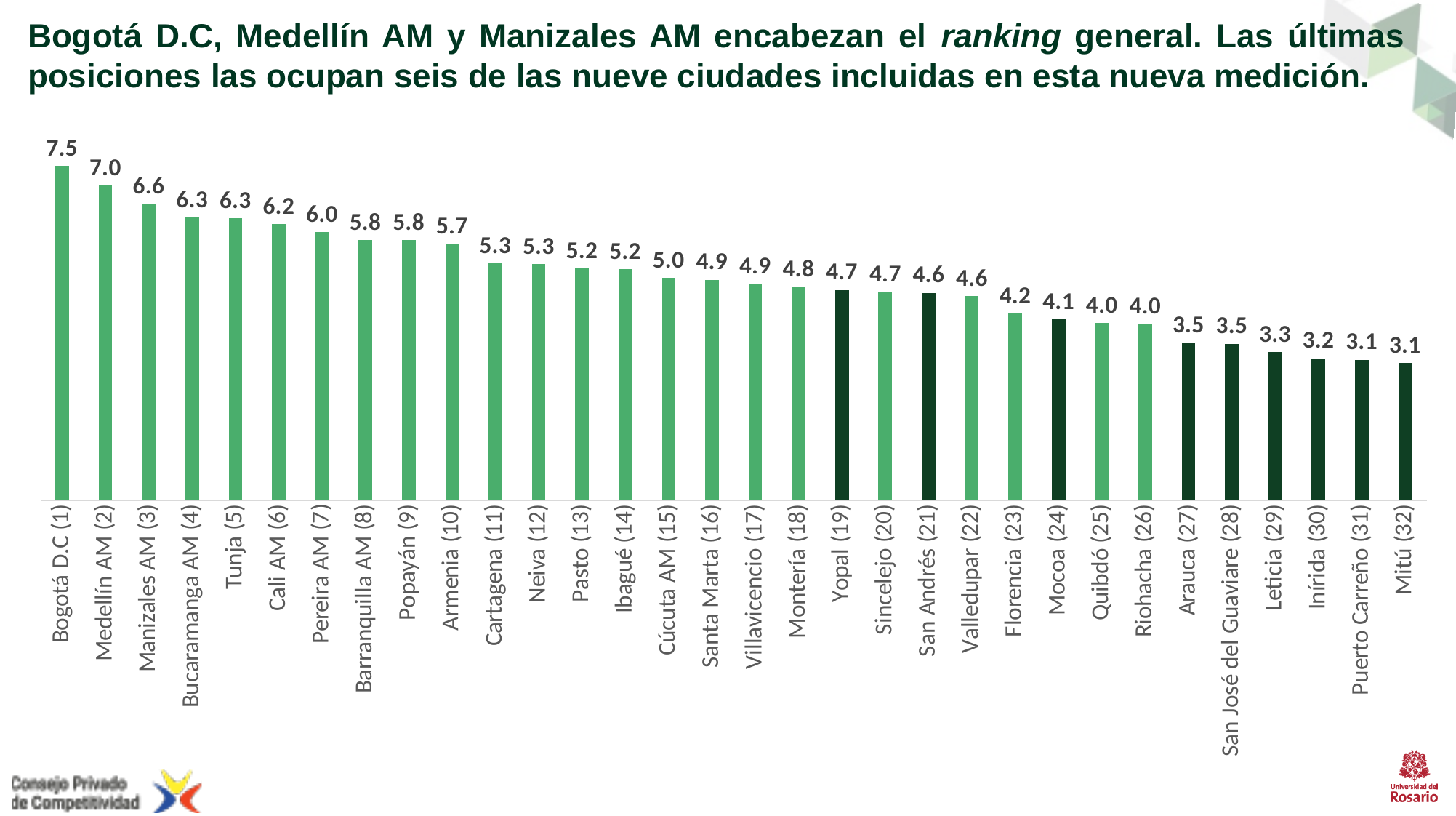
Which city has the highest value in the chart? Bogotá D.C (1) What is the value shown for Florencia (23)? 4.2 Do the values rise or fall from left to right along the x axis? Fall How many cities are shown in the chart? 32 What is the difference between the values for Medellín AM (2) and Manizales AM (3)? 0.4 What is the lowest value shown in the chart? 3.1 What kind of chart is shown on the slide? Bar chart Which has a larger value, Pereira AM (7) or Armenia (10)? Pereira AM (7) What is the value shown for Cúcuta AM (15)? 5.0 What is the value shown for Bogotá D.C (1)? 7.5 What is the difference between the values for Bogotá D.C (1) and Mitú (32)? 4.4 Which has a larger value, Leticia (29) or Riohacha (26)? Riohacha (26)